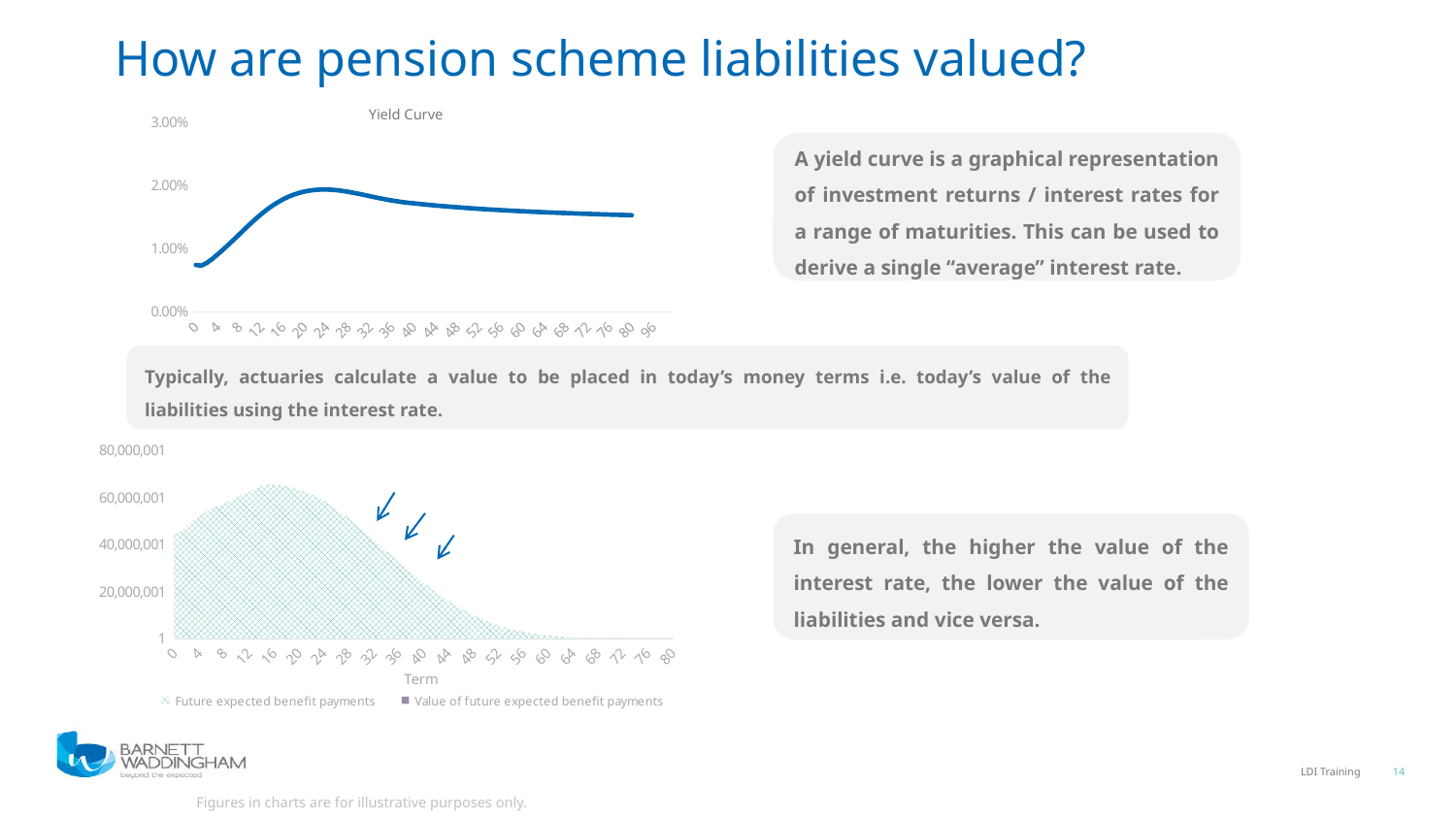
In the Yield Curve chart, is the value at term 0 greater or less than 1.00%? less In the Yield Curve chart, does the curve rise or fall between term 24 and term 96? fall In the bottom chart, is the peak value of Future expected benefit payments greater or less than 40,000,001? greater In the bottom chart, does the Future expected benefit payments series rise or fall between term 20 and term 60? fall What is the title of the chart at the top left of the slide? Yield Curve In the bottom chart, is the value of Future expected benefit payments at term 60 greater or less than 20,000,001? less In the Yield Curve chart, what is the highest value shown on the vertical axis? 3.00% What kind of chart is the Yield Curve chart at the top of the slide? line chart In the Yield Curve chart, does the curve rise or fall between term 0 and term 24? rise How many series does the legend of the bottom chart list? 2